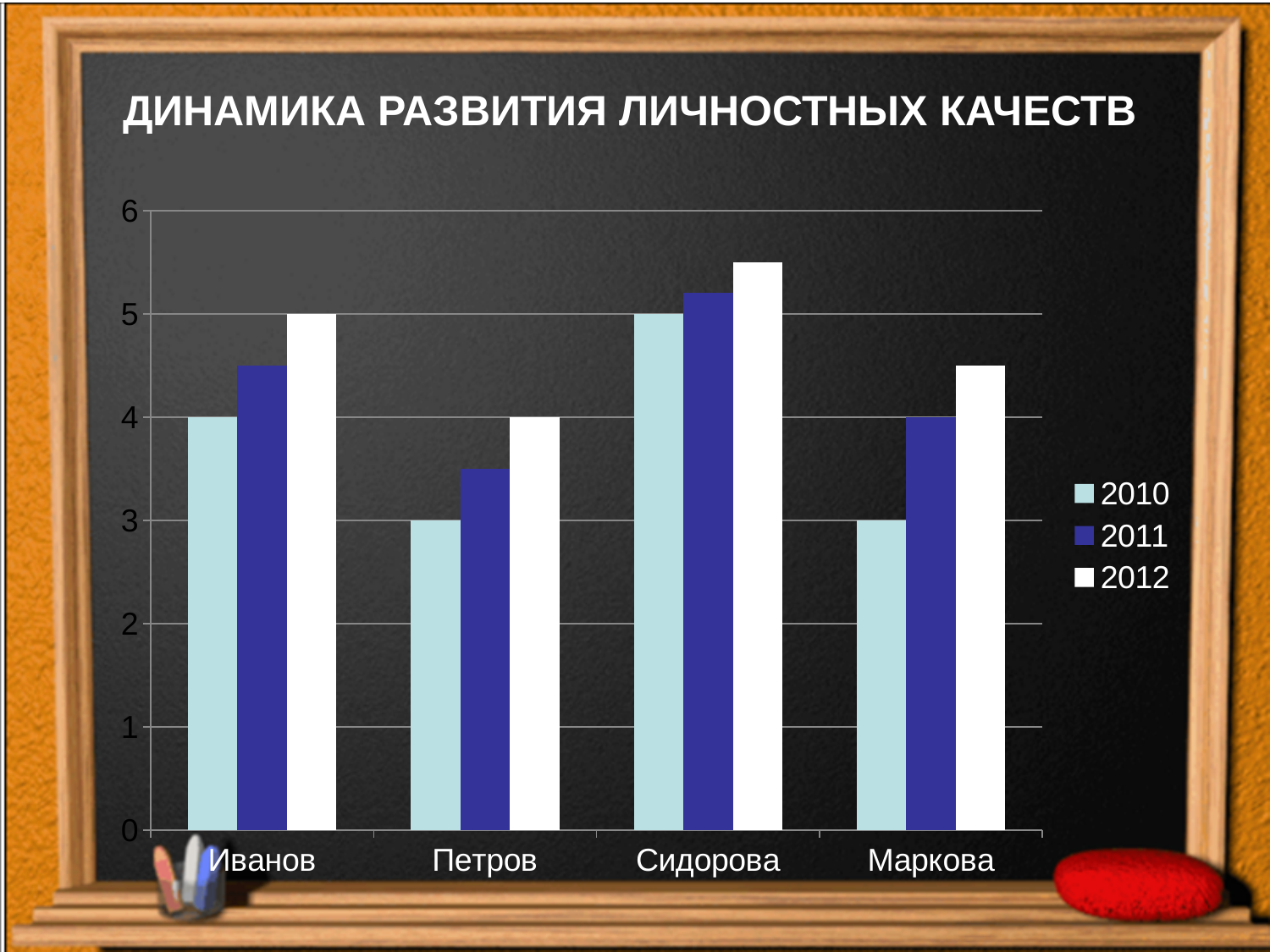
What is the value for Маркова in 2011? 4 What is the difference between the 2012 and 2010 values for Иванов? 1 What is the value for Петров in 2010? 3 Which category has the highest value in 2012? Сидорова Which category has the lowest value in 2011? Петров What kind of chart is shown on the slide? bar chart What is the value for Иванов in 2012? 5 Is the value for Сидорова in 2012 greater or less than 5? greater How many series does the legend list? 3 What is the value for Иванов in 2010? 4 How many categories are shown on the x axis? 4 Which is larger, the 2012 value for Петров or the 2012 value for Маркова? Маркова